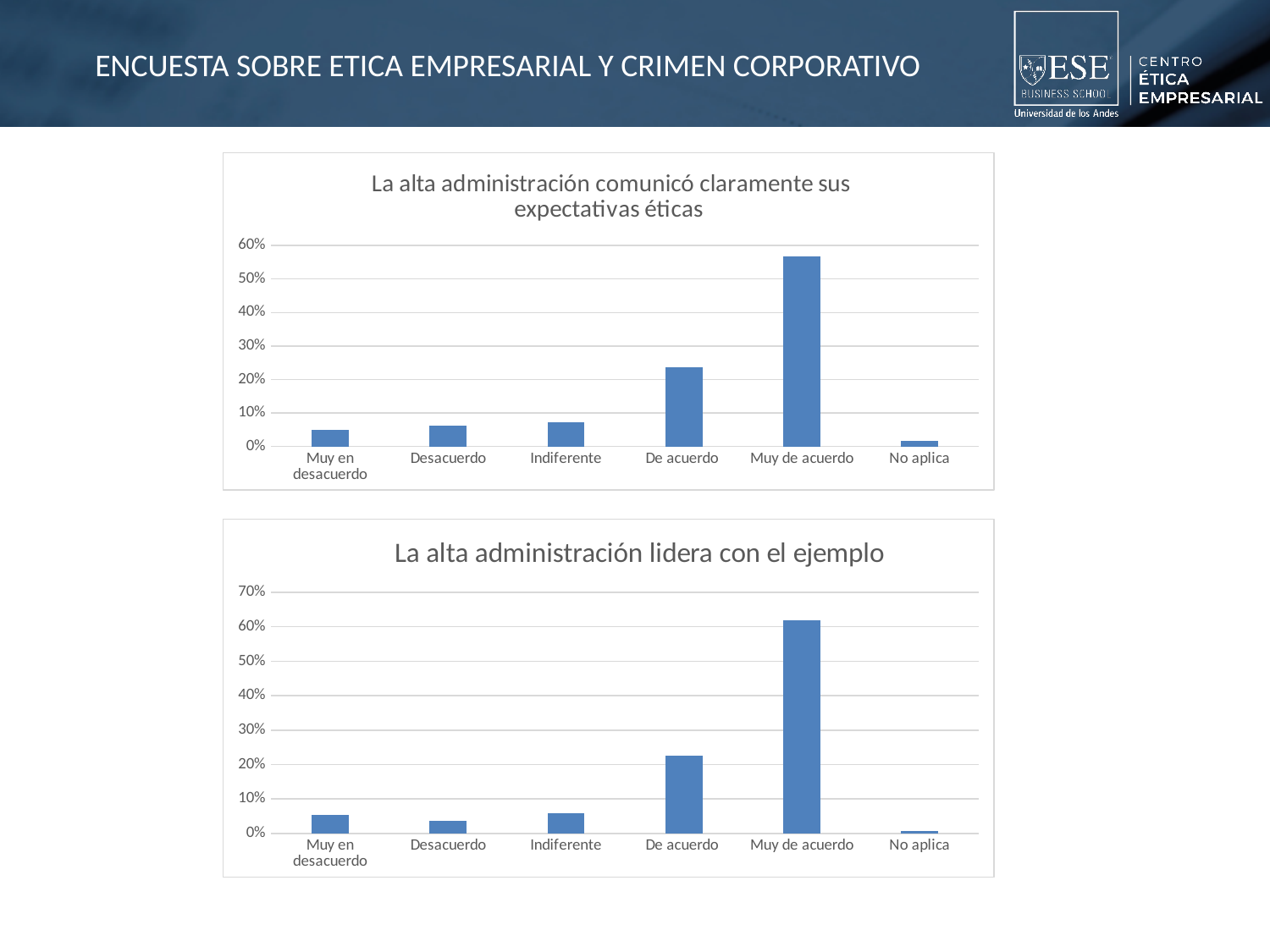
In the chart titled 'La alta administración lidera con el ejemplo', is the value for De acuerdo greater or less than 30%? less What type of chart is the bottom chart, 'La alta administración lidera con el ejemplo'? bar chart How many categories are shown on the x axis of the chart titled 'La alta administración comunicó claramente sus expectativas éticas'? 6 In the chart titled 'La alta administración lidera con el ejemplo', is the value for Muy de acuerdo greater or less than 50%? greater In the chart titled 'La alta administración comunicó claramente sus expectativas éticas', is the value for Muy de acuerdo greater or less than 50%? greater In the chart titled 'La alta administración lidera con el ejemplo', which category has the highest value? Muy de acuerdo In the chart titled 'La alta administración comunicó claramente sus expectativas éticas', which category has the highest value? Muy de acuerdo In the chart titled 'La alta administración comunicó claramente sus expectativas éticas', which is larger: De acuerdo or Desacuerdo? De acuerdo In the chart titled 'La alta administración comunicó claramente sus expectativas éticas', which category has the lowest value? No aplica In the chart titled 'La alta administración lidera con el ejemplo', which category has the lowest value? No aplica What is the highest value shown on the y axis of the bottom chart, 'La alta administración lidera con el ejemplo'? 70%